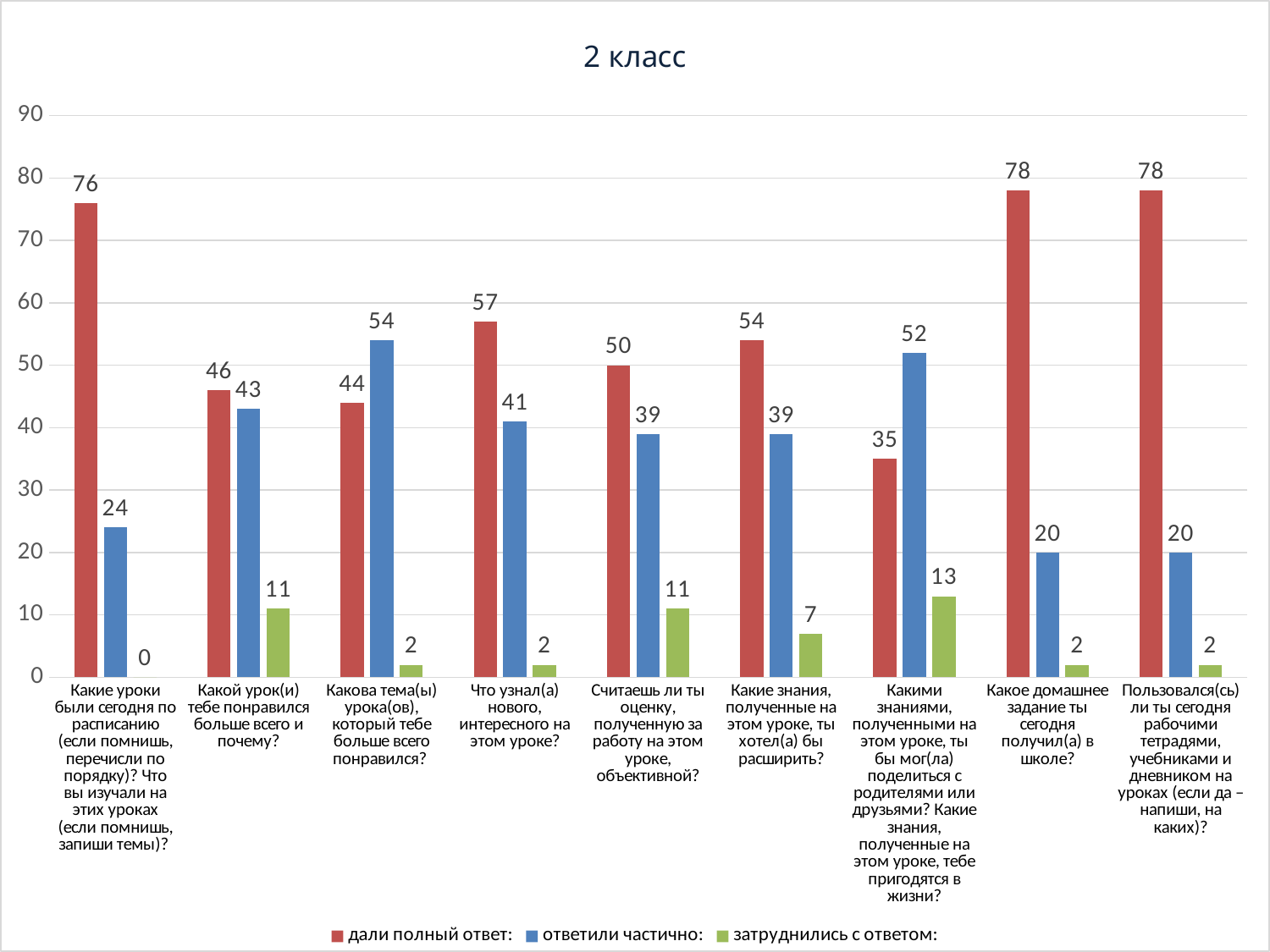
For which question is the 'ответили частично:' value the highest? Какова тема(ы) урока(ов), который тебе больше всего понравился? How many series does the legend list? 3 For 'Какова тема(ы) урока(ов), который тебе больше всего понравился?', which is larger: 'дали полный ответ:' or 'ответили частично:'? ответили частично: What is the title of the chart? 2 класс How many question categories are shown on the x axis? 9 What is the value of 'дали полный ответ:' for 'Какое домашнее задание ты сегодня получил(а) в школе?'? 78 What is the value of 'ответили частично:' for 'Что узнал(а) нового, интересного на этом уроке?'? 41 What is the highest value of 'затруднились с ответом:' across all questions? 13 What type of chart is shown on the slide? bar chart For which question is the 'дали полный ответ:' value the lowest? Какими знаниями, полученными на этом уроке, ты бы мог(ла) поделиться с родителями или друзьями? Какие знания, полученные на этом уроке, тебе пригодятся в жизни? What is the value of 'затруднились с ответом:' for 'Какой урок(и) тебе понравился больше всего и почему?'? 11 What is the difference between 'дали полный ответ:' and 'ответили частично:' for 'Какие уроки были сегодня по расписанию...'? 52